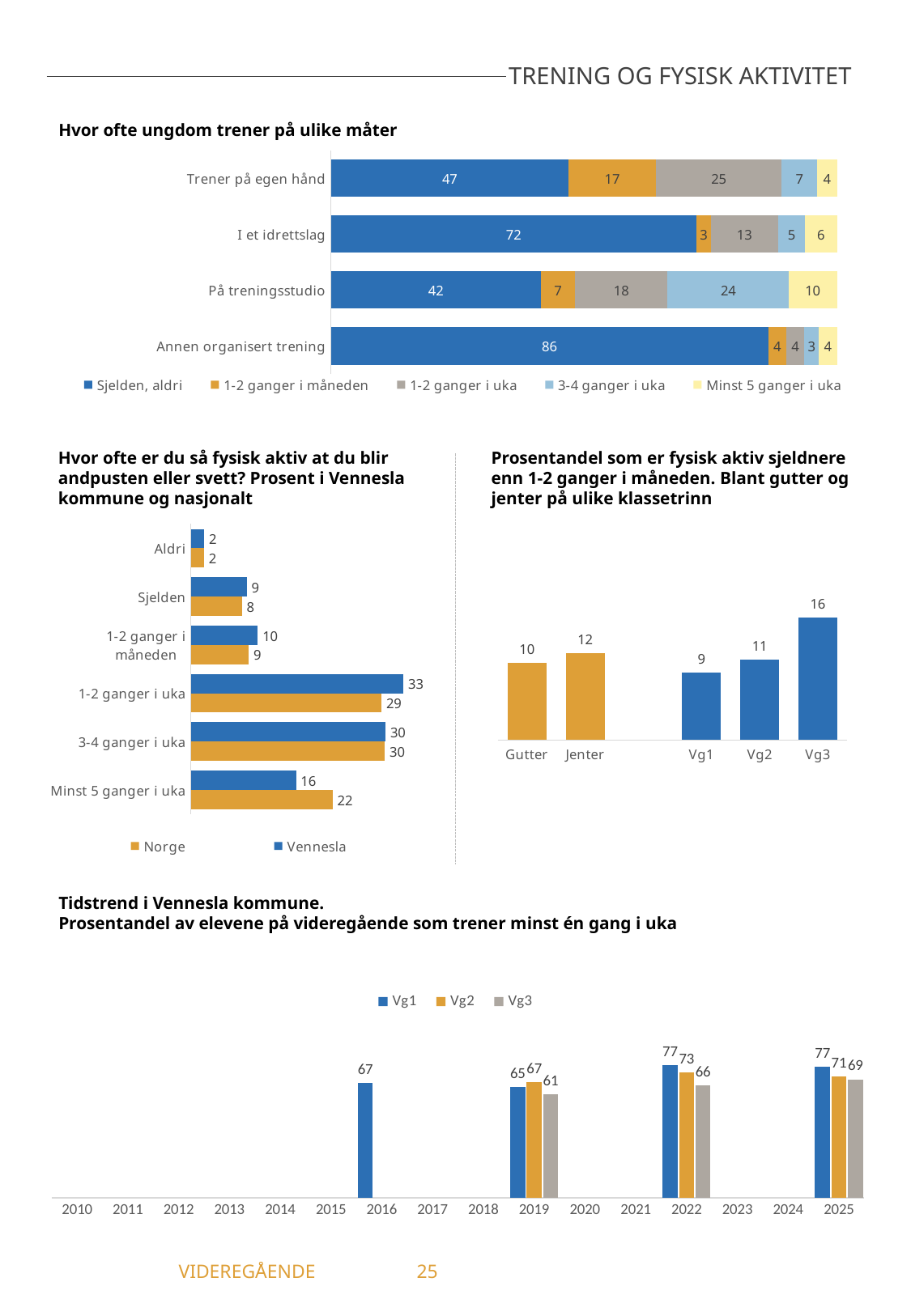
In the chart 'Tidstrend i Vennesla kommune', what is the Vg2 value for 2022? 73 In the chart 'Hvor ofte ungdom trener på ulike måter', which category has the highest 'Sjelden, aldri' value? Annen organisert trening In the chart 'Hvor ofte ungdom trener på ulike måter', how many series does the legend list? 5 In the chart 'Hvor ofte er du så fysisk aktiv at du blir andpusten eller svett?', what is the Vennesla value for '1-2 ganger i uka'? 33 In the chart 'Prosentandel som er fysisk aktiv sjeldnere enn 1-2 ganger i måneden', what is the value for Jenter? 12 In the chart 'Tidstrend i Vennesla kommune', which is larger, the Vg1 value for 2019 or the Vg1 value for 2025? 2025 In the chart 'Hvor ofte er du så fysisk aktiv at du blir andpusten eller svett?', how many categories are shown? 6 In the chart 'Hvor ofte ungdom trener på ulike måter', what is the total of the 'På treningsstudio' stacked bar? 101 In the chart 'Hvor ofte er du så fysisk aktiv at du blir andpusten eller svett?', what is the difference between the Norge and Vennesla values for 'Minst 5 ganger i uka'? 6 What kind of chart is 'Tidstrend i Vennesla kommune'? Bar chart In the chart 'Prosentandel som er fysisk aktiv sjeldnere enn 1-2 ganger i måneden', which category has the highest value? Vg3 In the chart 'Hvor ofte ungdom trener på ulike måter', what is the value for 'Sjelden, aldri' in the 'I et idrettslag' bar? 72